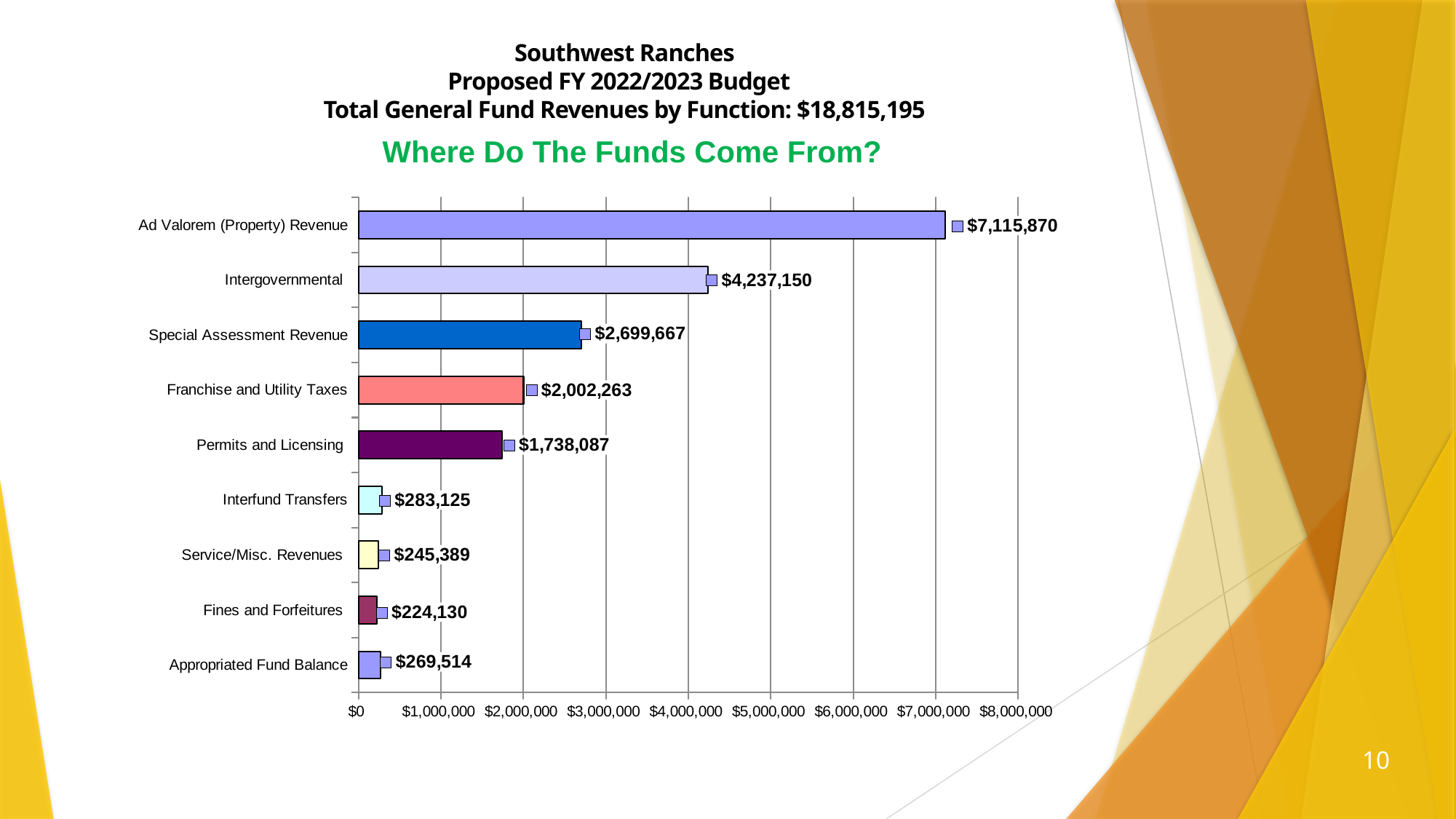
What is the difference between Special Assessment Revenue and Franchise and Utility Taxes? $697,404 What is the value for Special Assessment Revenue? $2,699,667 How many categories are shown in the chart? 9 Which is larger, Interfund Transfers or Service/Misc. Revenues? Interfund Transfers Which category has the lowest value? Fines and Forfeitures What is the value for Ad Valorem (Property) Revenue? $7,115,870 What is the value for Fines and Forfeitures? $224,130 Which category has the highest value? Ad Valorem (Property) Revenue What is the difference between Ad Valorem (Property) Revenue and Intergovernmental? $2,878,720 Is the value for Intergovernmental greater or less than $4,000,000? greater What is the green heading above the chart? Where Do The Funds Come From? What kind of chart is shown on the slide? bar chart